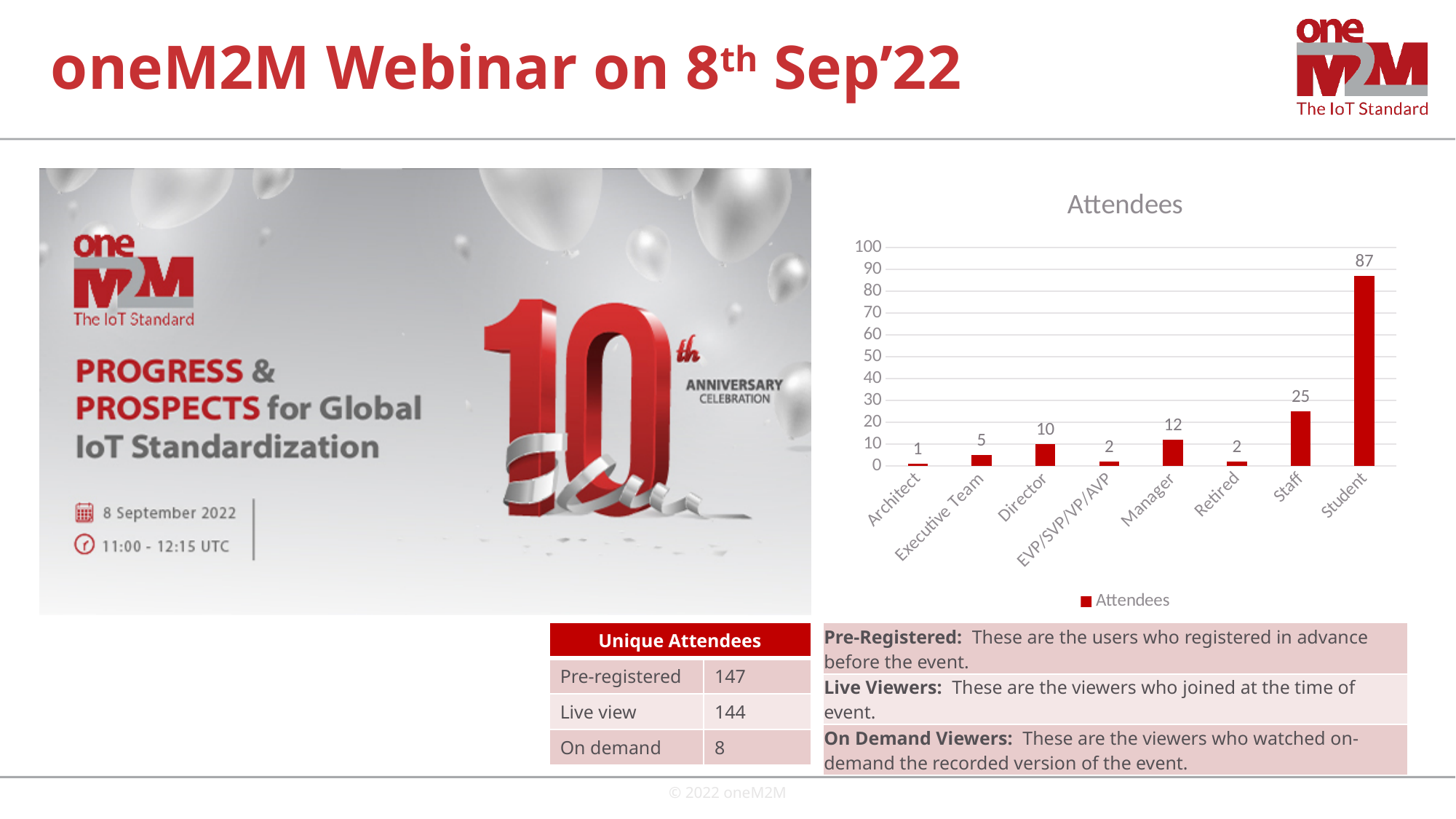
What is the number of attendees for Manager? 12 What is the number of attendees for Student? 87 Which category has the highest number of attendees? Student Which category has the lowest number of attendees? Architect Which has more attendees, Manager or Executive Team? Manager How many categories are shown on the x axis of the chart? 8 What is the difference in attendees between Student and Staff? 62 What is the number of attendees for Staff? 25 What type of chart is shown on the slide? Bar chart What is the number of attendees for Director? 10 How many series does the chart legend list? 1 Is the value for Student greater or less than 80? greater